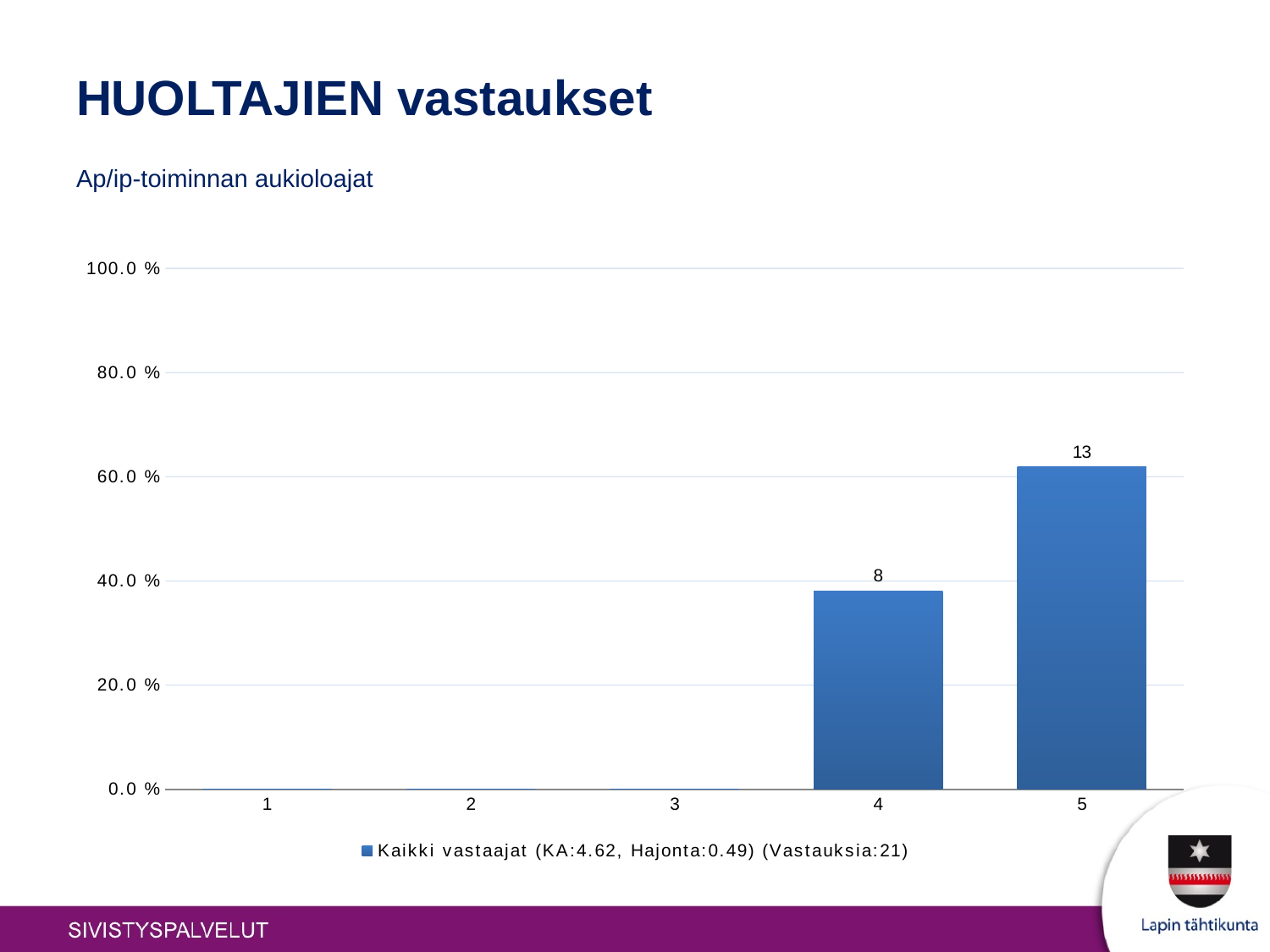
Which bar is taller, category 4 or category 5? 5 How many series does the legend list? 1 Is the value for category 4 greater or less than 20.0 %? greater What is the difference between the data labels for categories 5 and 4? 5 Which category has the tallest bar? 5 Is the value for category 5 greater or less than 40.0 %? greater How many categories are shown on the x axis? 5 Is the value for category 5 greater or less than 80.0 %? less What data label is shown above the bar for category 4? 8 What kind of chart is shown on the slide? bar chart According to the legend, how many responses (Vastauksia) does the chart represent? 21 What data label is shown above the bar for category 5? 13